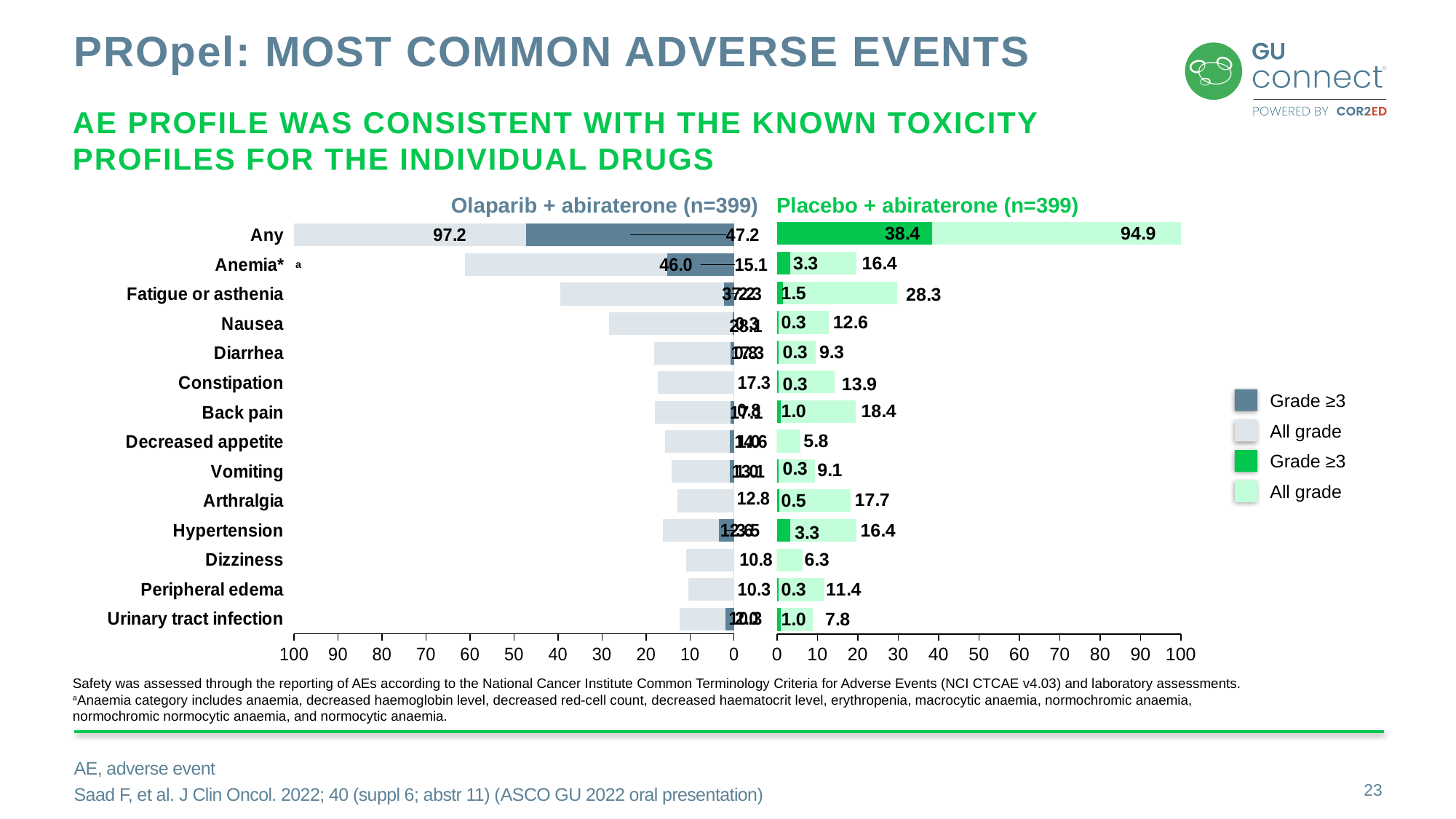
In the Olaparib + abiraterone group, what is the all-grade value for Anemia? 46.0 What is the difference between the all-grade Any adverse event values for Olaparib + abiraterone (97.2) and Placebo + abiraterone (94.9)? 2.3 In the Placebo + abiraterone group, what is the all-grade value for Arthralgia? 17.7 How many entries does the legend list? 4 In the Olaparib + abiraterone group, what is the all-grade value for Any adverse event? 97.2 Which group has the higher Grade ≥3 value for Anemia, Olaparib + abiraterone or Placebo + abiraterone? Olaparib + abiraterone In the Placebo + abiraterone group, what is the Grade ≥3 value for Any adverse event? 38.4 In the Placebo + abiraterone group, what is the all-grade value for Fatigue or asthenia? 28.3 What is the sample size (n) shown for each treatment group in the chart headings? 399 What kind of chart is shown on the slide? bar chart Which adverse event category has the lowest all-grade value in the Placebo + abiraterone group? Decreased appetite How many adverse event categories are listed on the chart? 14